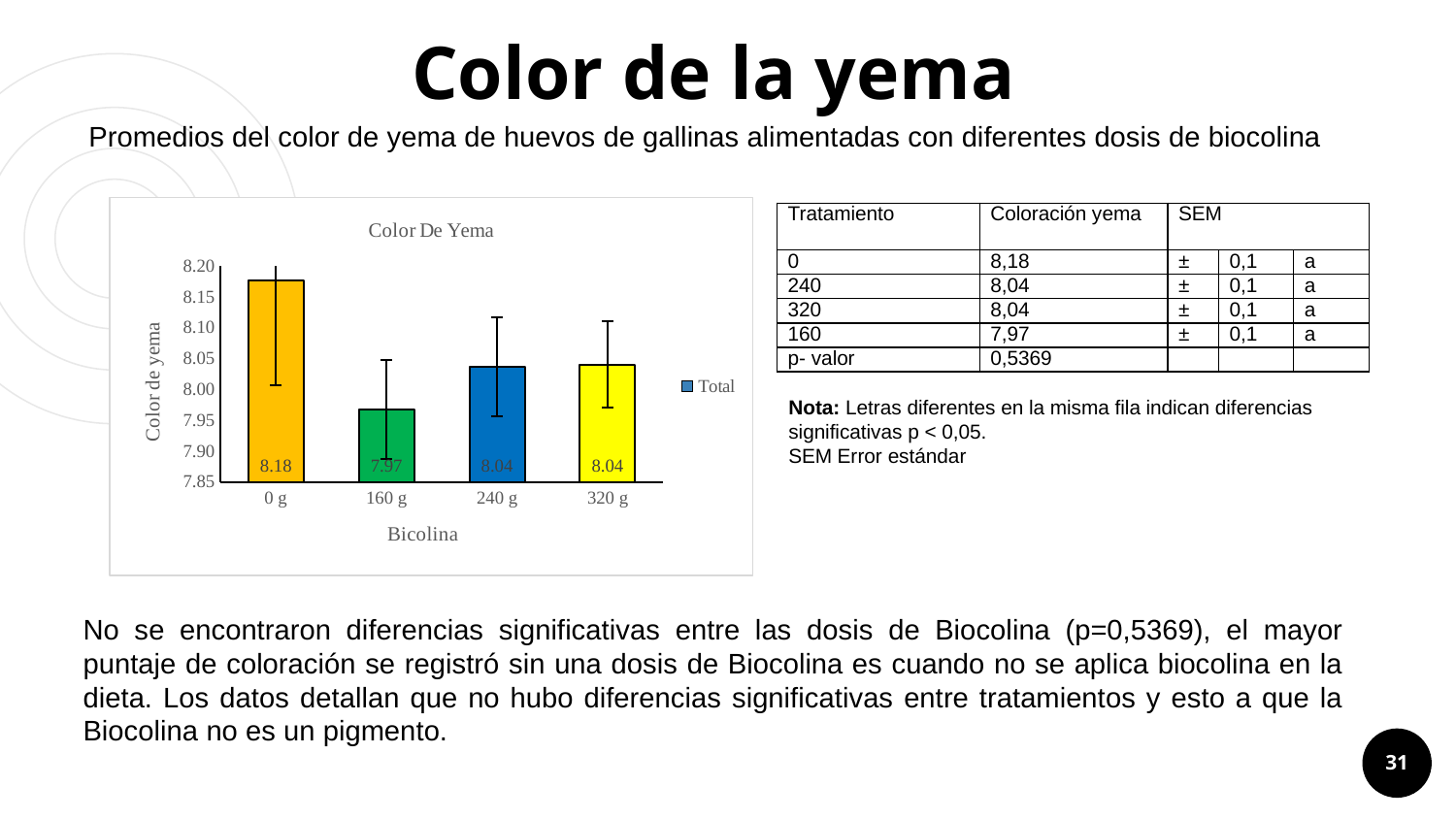
How many categories are shown on the x axis of the chart? 4 What is the title of the chart? Color De Yema What is the label of the x axis of the chart? Bicolina Which is larger, the value for 0 g or the value for 240 g? 0 g What type of chart is shown on the slide? bar chart Which Bicolina dose has the lowest yolk color value? 160 g What is the difference between the values for 0 g and 160 g? 0.21 What is the value for 0 g in the Color De Yema chart? 8.18 What is the value for 240 g in the Color De Yema chart? 8.04 How many series does the chart legend list? 1 Which Bicolina dose has the highest yolk color value? 0 g What is the value for 160 g in the Color De Yema chart? 7.97